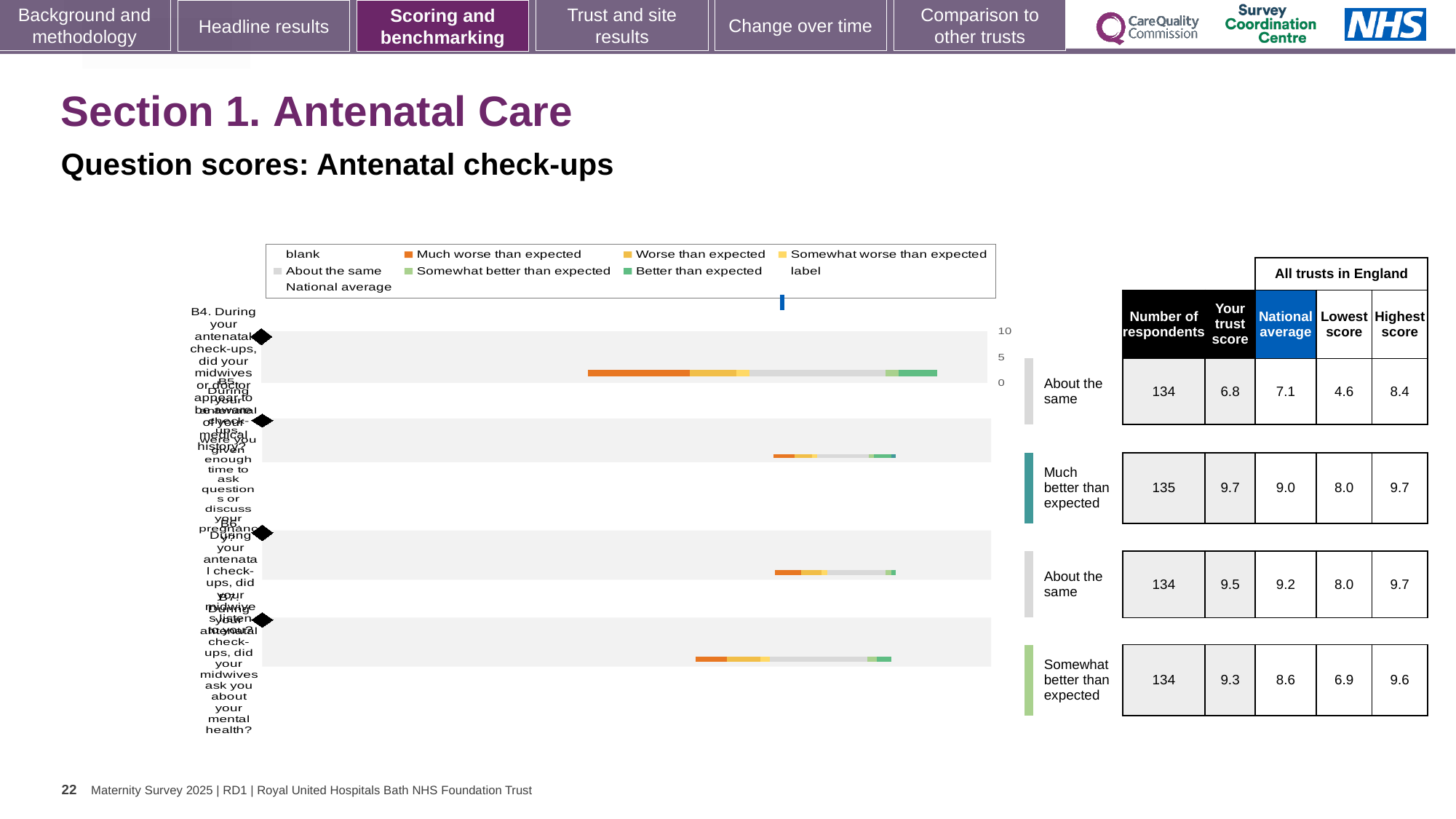
In the table beside the chart, how many respondents are listed for the row labelled 'Much better than expected'? 135 In the table beside the chart, which row has the highest 'Your trust score'? Much better than expected What kind of chart is shown on the slide? Bar chart In the table beside the chart, what is the difference between 'Your trust score' and 'National average' for the row labelled 'Much better than expected'? 0.7 In the table beside the chart, what is the 'Highest score' for the row labelled 'Somewhat better than expected'? 9.6 What is the highest tick value shown on the chart's axis? 10 In the table beside the chart, what is the 'Your trust score' for the row labelled 'Much better than expected'? 9.7 In the table beside the chart, what is the lowest 'Your trust score' value? 6.8 In the first row of the table beside the chart, which is larger: 'Your trust score' or 'National average'? National average How many question bars are plotted in the chart? 4 What is the subtitle describing the chart on the slide? Question scores: Antenatal check-ups In the table beside the chart, what is the 'Lowest score' in the first row (the first 'About the same' row)? 4.6